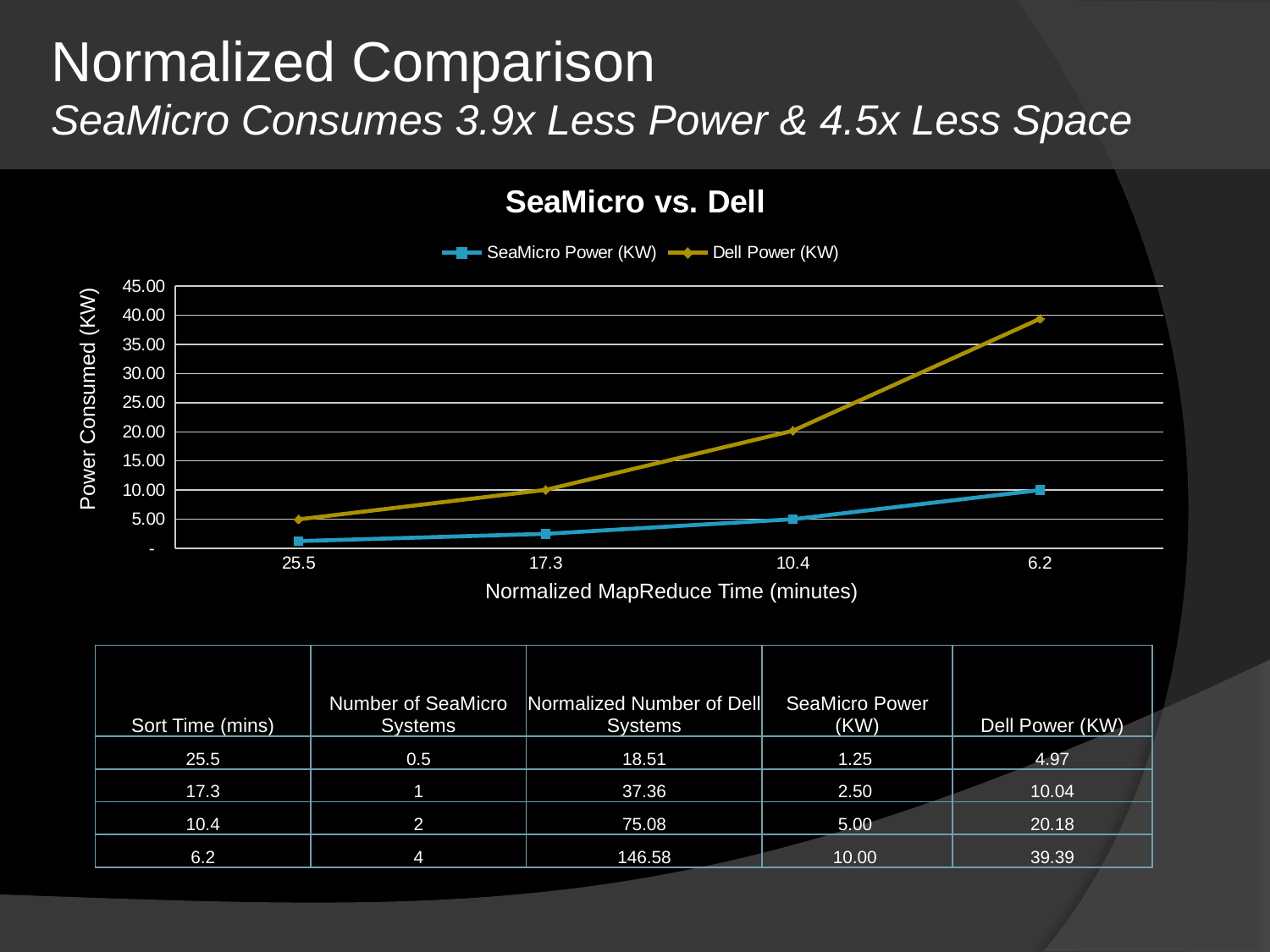
What is the Dell Power (KW) value at a normalized MapReduce time of 6.2 minutes? 39.39 At which normalized MapReduce time is Dell Power (KW) highest? 6.2 What is the difference between Dell Power (KW) and SeaMicro Power (KW) at a normalized MapReduce time of 10.4 minutes? 15.18 Is the Dell Power (KW) value at 6.2 minutes greater or less than 35.00? greater What is the SeaMicro Power (KW) value at a normalized MapReduce time of 17.3 minutes? 2.50 How many points are plotted along the x axis for each series? 4 What type of chart is shown on the slide? line chart At which normalized MapReduce time is SeaMicro Power (KW) lowest? 25.5 What is the title of the chart? SeaMicro vs. Dell Do the Dell Power (KW) values rise or fall moving left to right along the x axis? rise How many series does the chart legend list? 2 Which series has the larger value at a normalized MapReduce time of 10.4 minutes, SeaMicro Power (KW) or Dell Power (KW)? Dell Power (KW)